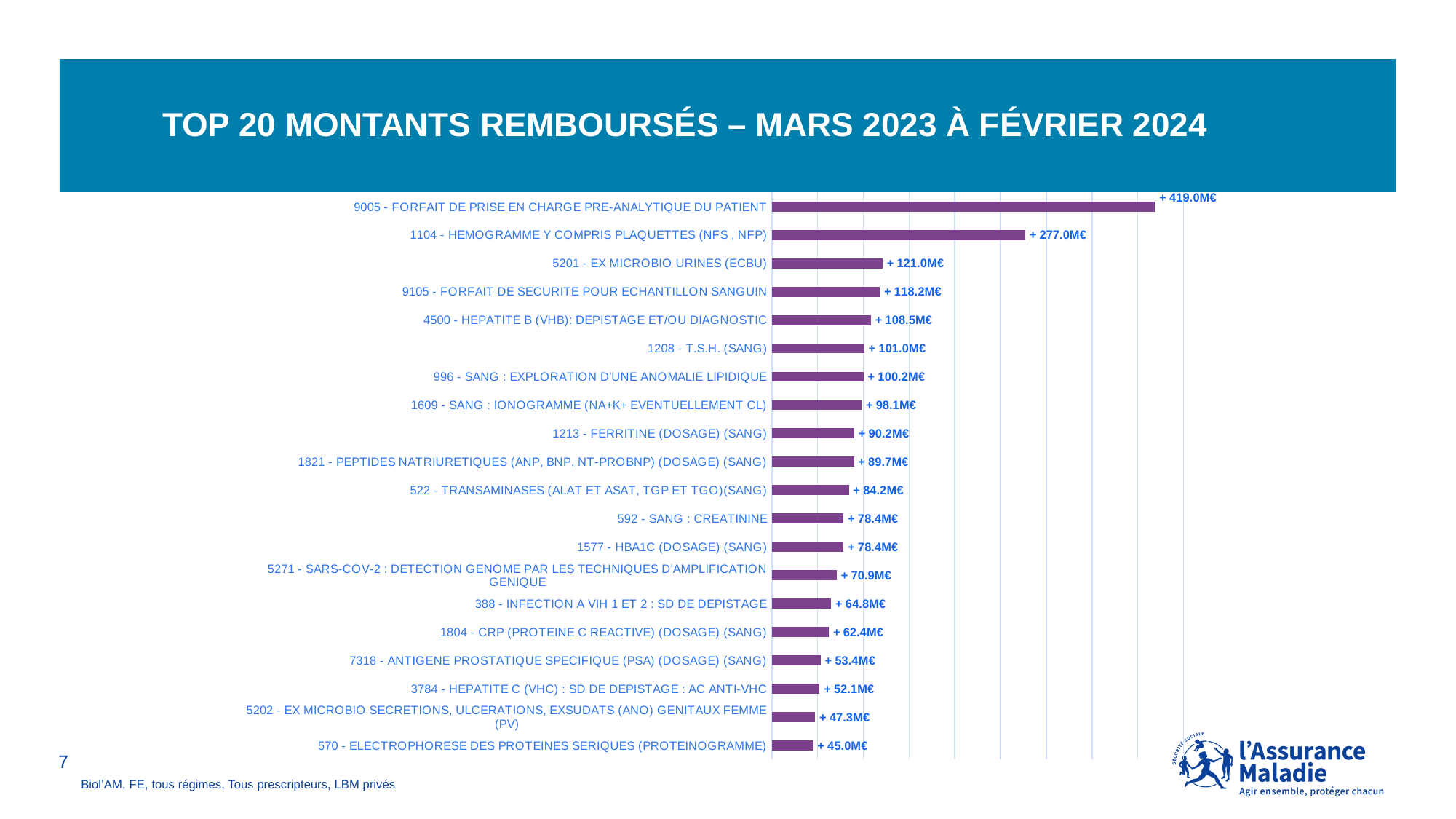
What is the value shown for 5271 - SARS-COV-2 : DETECTION GENOME PAR LES TECHNIQUES D'AMPLIFICATION GENIQUE? + 70.9M€ What is the title of the slide? TOP 20 MONTANTS REMBOURSÉS – MARS 2023 À FÉVRIER 2024 How many categories are plotted in the chart? 20 What is the value shown for 1208 - T.S.H. (SANG)? + 101.0M€ Which category has the lowest value? 570 - ELECTROPHORESE DES PROTEINES SERIQUES (PROTEINOGRAMME) What is the value shown for 570 - ELECTROPHORESE DES PROTEINES SERIQUES (PROTEINOGRAMME)? + 45.0M€ Which category has the highest value? 9005 - FORFAIT DE PRISE EN CHARGE PRE-ANALYTIQUE DU PATIENT Which has a larger value: 1213 - FERRITINE (DOSAGE) (SANG) or 388 - INFECTION A VIH 1 ET 2 : SD DE DEPISTAGE? 1213 - FERRITINE (DOSAGE) (SANG) What is the value shown for 9005 - FORFAIT DE PRISE EN CHARGE PRE-ANALYTIQUE DU PATIENT? + 419.0M€ What is the difference between the values for 9005 - FORFAIT DE PRISE EN CHARGE PRE-ANALYTIQUE DU PATIENT and 1104 - HEMOGRAMME Y COMPRIS PLAQUETTES (NFS , NFP)? 142.0M€ What is the difference between the values for 5201 - EX MICROBIO URINES (ECBU) and 9105 - FORFAIT DE SECURITE POUR ECHANTILLON SANGUIN? 2.8M€ What kind of chart is shown on the slide? Bar chart